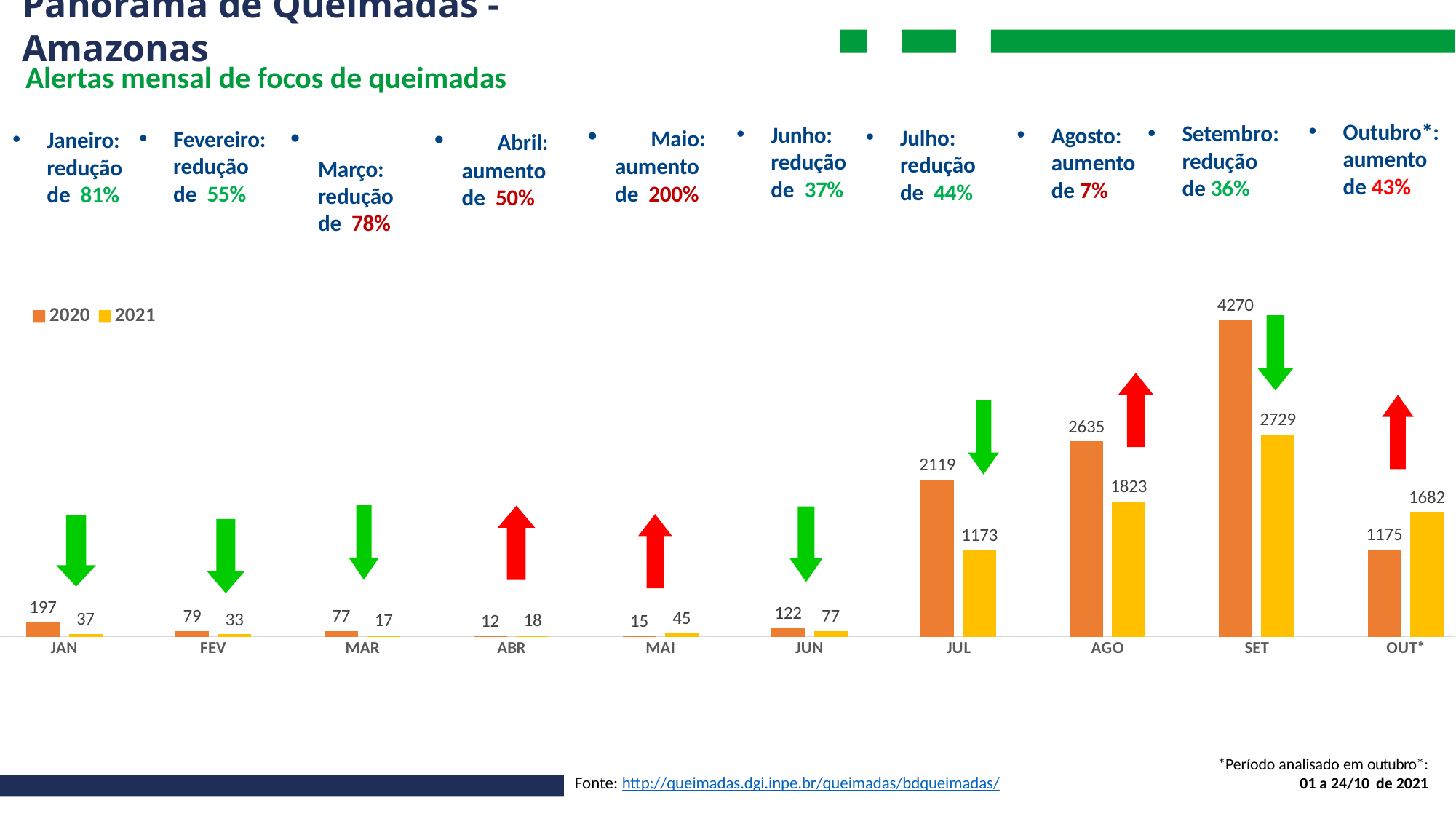
How many months are shown on the x axis? 10 What is the value for 2021 in JUL? 1173 Which is larger in MAI, the 2020 value or the 2021 value? 2021 What is the difference between the 2020 and 2021 values in AGO? 812 What is the value for 2020 in SET? 4270 Which series is shown in orange in the legend? 2020 What is the total of the 2020 and 2021 values in JAN? 234 Which month has the lowest value for the 2021 series? MAR How many series does the legend list? 2 What is the value for 2021 in OUT*? 1682 What kind of chart is shown on the slide? bar chart Which month has the highest value for the 2020 series? SET